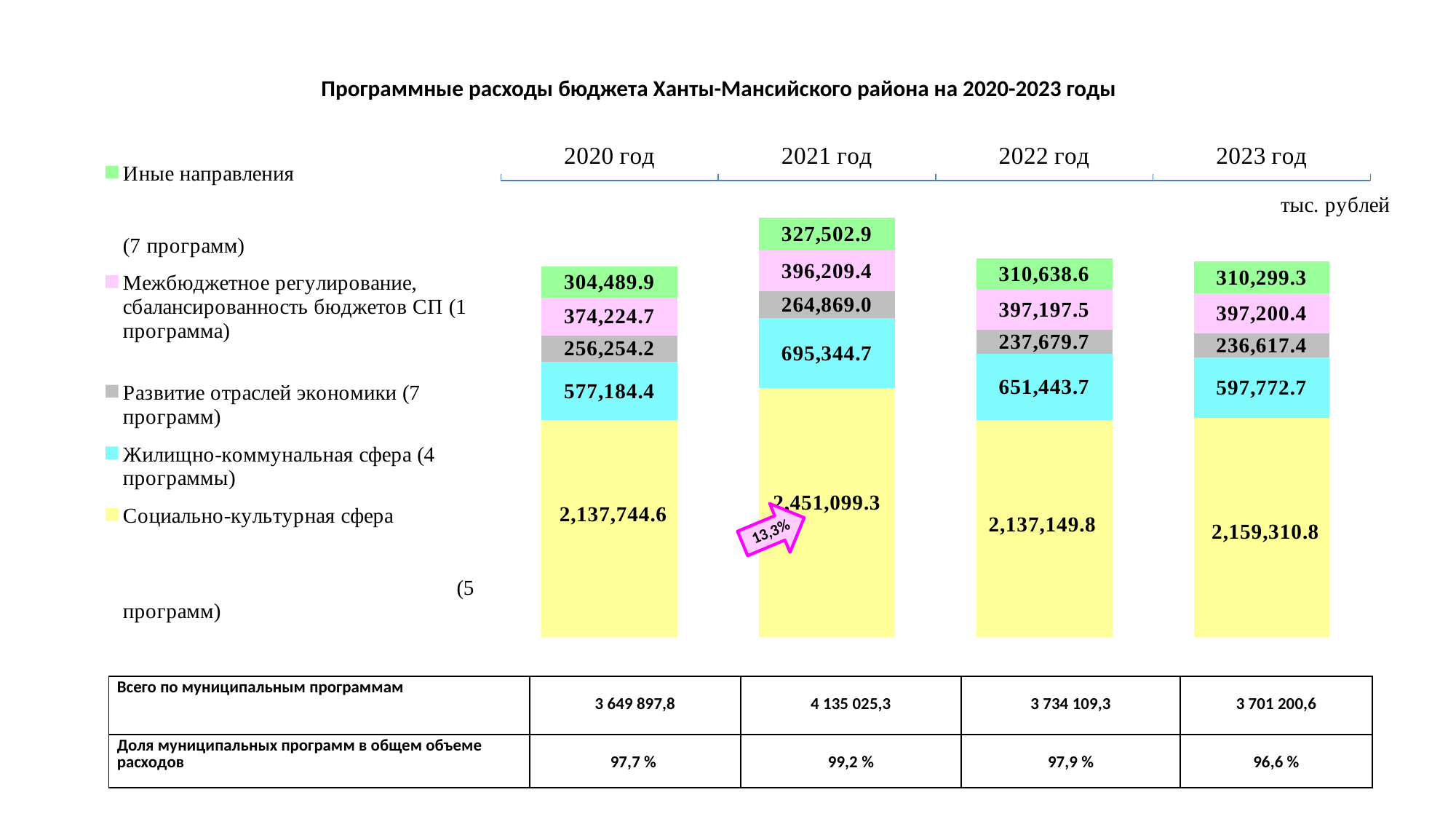
Which is larger: Межбюджетное регулирование in 2021 год or Иные направления in 2021 год? Межбюджетное регулирование What is the value for Развитие отраслей экономики in 2022 год? 237,679.7 In which year is the value for Жилищно-коммунальная сфера the highest? 2021 год In which year is the value for Социально-культурная сфера the lowest? 2022 год What is the value for Жилищно-коммунальная сфера in 2021 год? 695,344.7 What is the value for Иные направления in 2020 год? 304,489.9 How many series does the legend list? 5 What is the total of the stacked bar for 2021 год (Всего по муниципальным программам)? 4 135 025,3 What is the difference between the Жилищно-коммунальная сфера values for 2021 год and 2020 год? 118,160.3 What is the value for Социально-культурная сфера in 2023 год? 2,159,310.8 How many years (bars) are shown in the chart? 4 What kind of chart is shown on the slide? Stacked bar chart